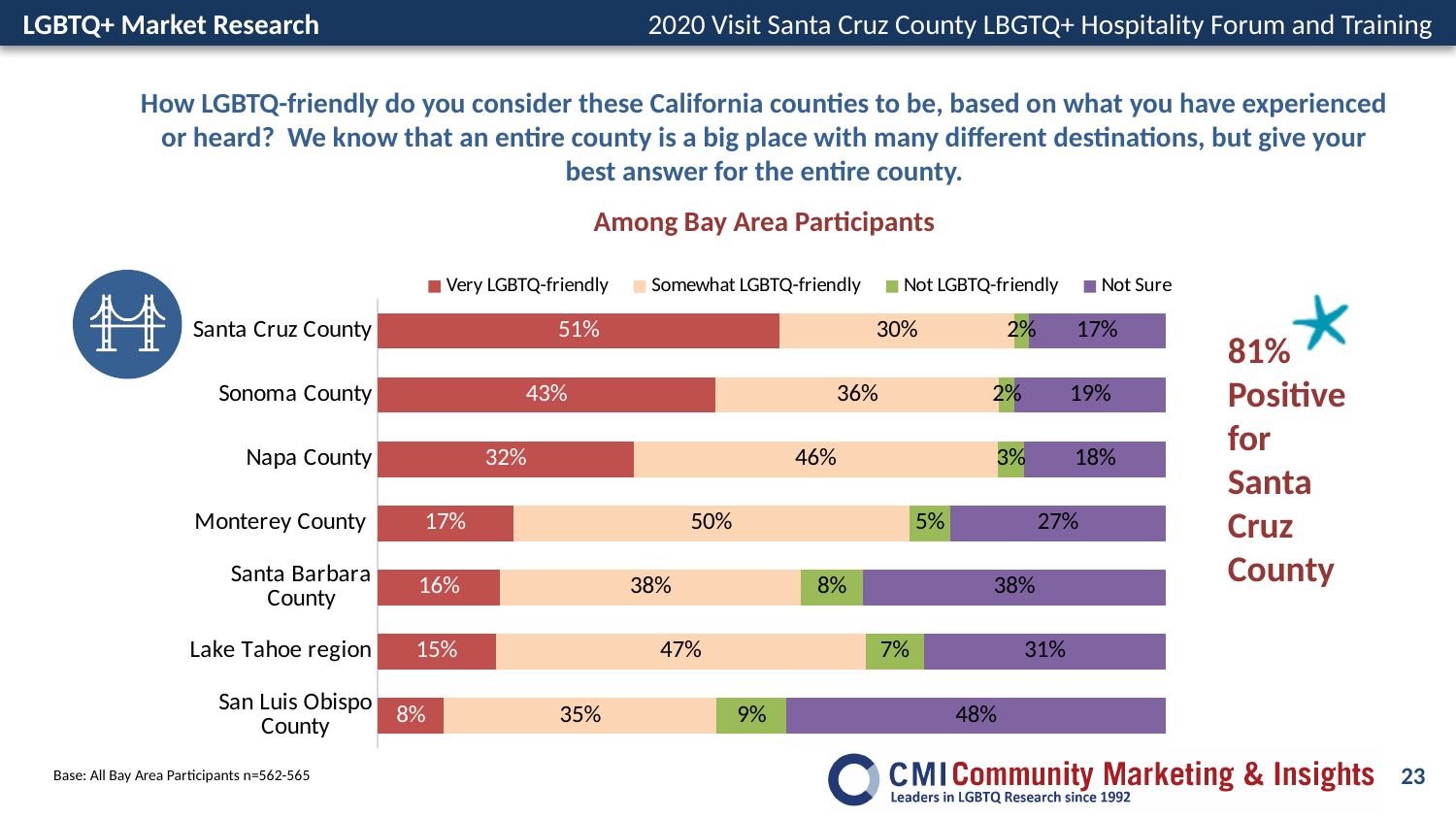
What is the difference between the Very LGBTQ-friendly values for Santa Cruz County and Sonoma County? 8 percentage points What percentage of Bay Area participants rated Santa Cruz County as Very LGBTQ-friendly? 51% Which legend entry is shown in green? Not LGBTQ-friendly What is the combined Very and Somewhat LGBTQ-friendly percentage for Santa Cruz County? 81% How many series does the legend list? 4 Which is larger: the Not Sure value for Monterey County or for Lake Tahoe region? Lake Tahoe region How many counties or regions are shown in the chart? 7 What is the Somewhat LGBTQ-friendly value for Napa County? 46% What is the Not Sure value for San Luis Obispo County? 48% What type of chart is shown on the slide? Stacked bar chart Which county has the highest Very LGBTQ-friendly percentage? Santa Cruz County Which region has the lowest Very LGBTQ-friendly percentage? San Luis Obispo County